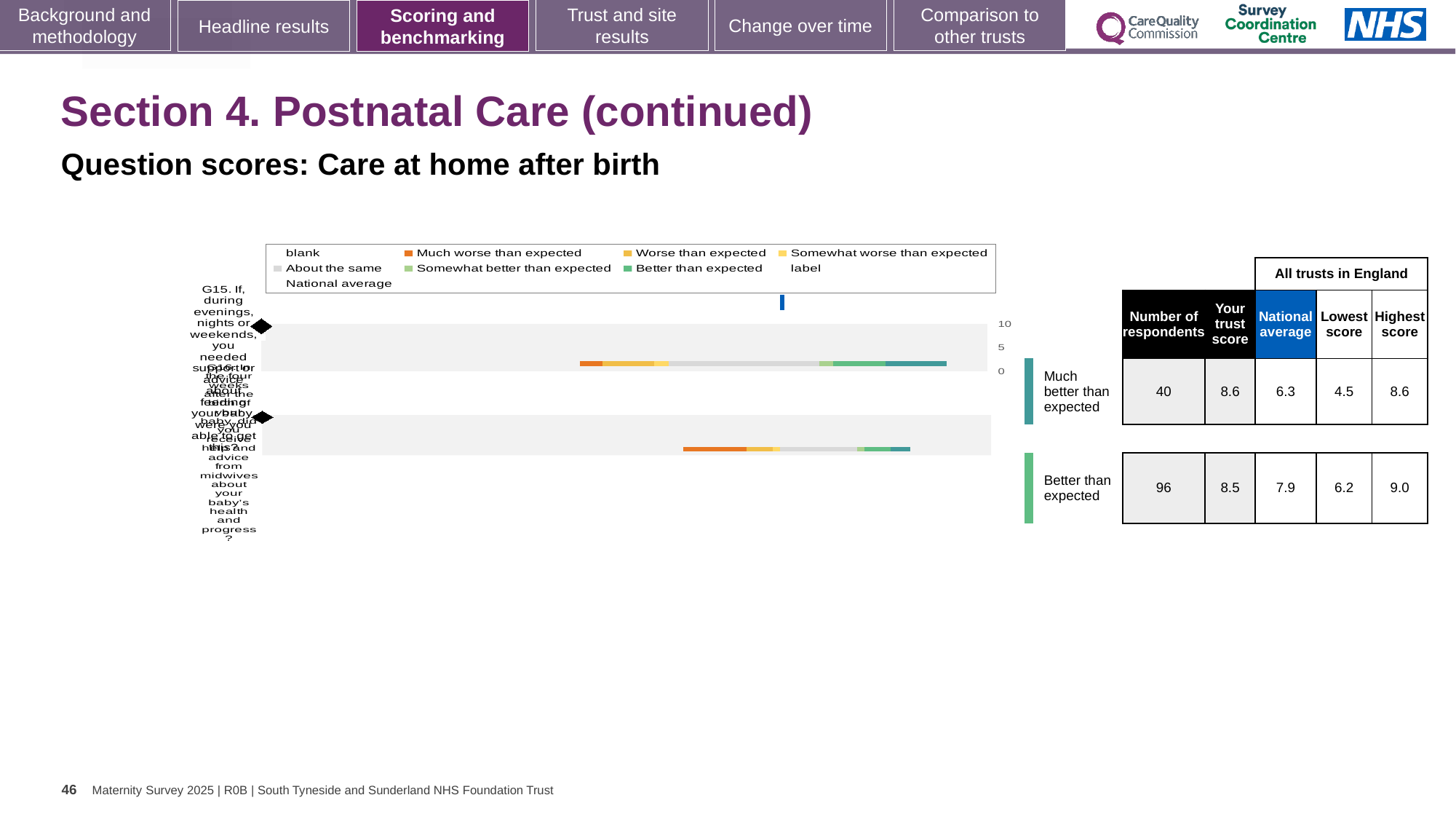
In the table, what is the number of respondents for the row labelled 'Better than expected'? 96 How many question bars are plotted in the chart? 2 In the table, what is the national average for the row labelled 'Much better than expected'? 6.3 In the table, what is the trust score for the row labelled 'Much better than expected'? 8.6 In the table, what is the highest score for the row labelled 'Better than expected'? 9.0 For the row labelled 'Better than expected', which is larger: the trust score or the national average? Trust score What kind of chart is shown on the slide? Stacked bar chart For the row labelled 'Much better than expected', what is the difference between the trust score and the national average? 2.3 What is the difference in number of respondents between the 'Better than expected' row and the 'Much better than expected' row? 56 In the table, what is the number of respondents for the row labelled 'Much better than expected'? 40 In the table, what is the lowest score for the row labelled 'Better than expected'? 6.2 What is the subtitle of the chart section on the slide? Question scores: Care at home after birth